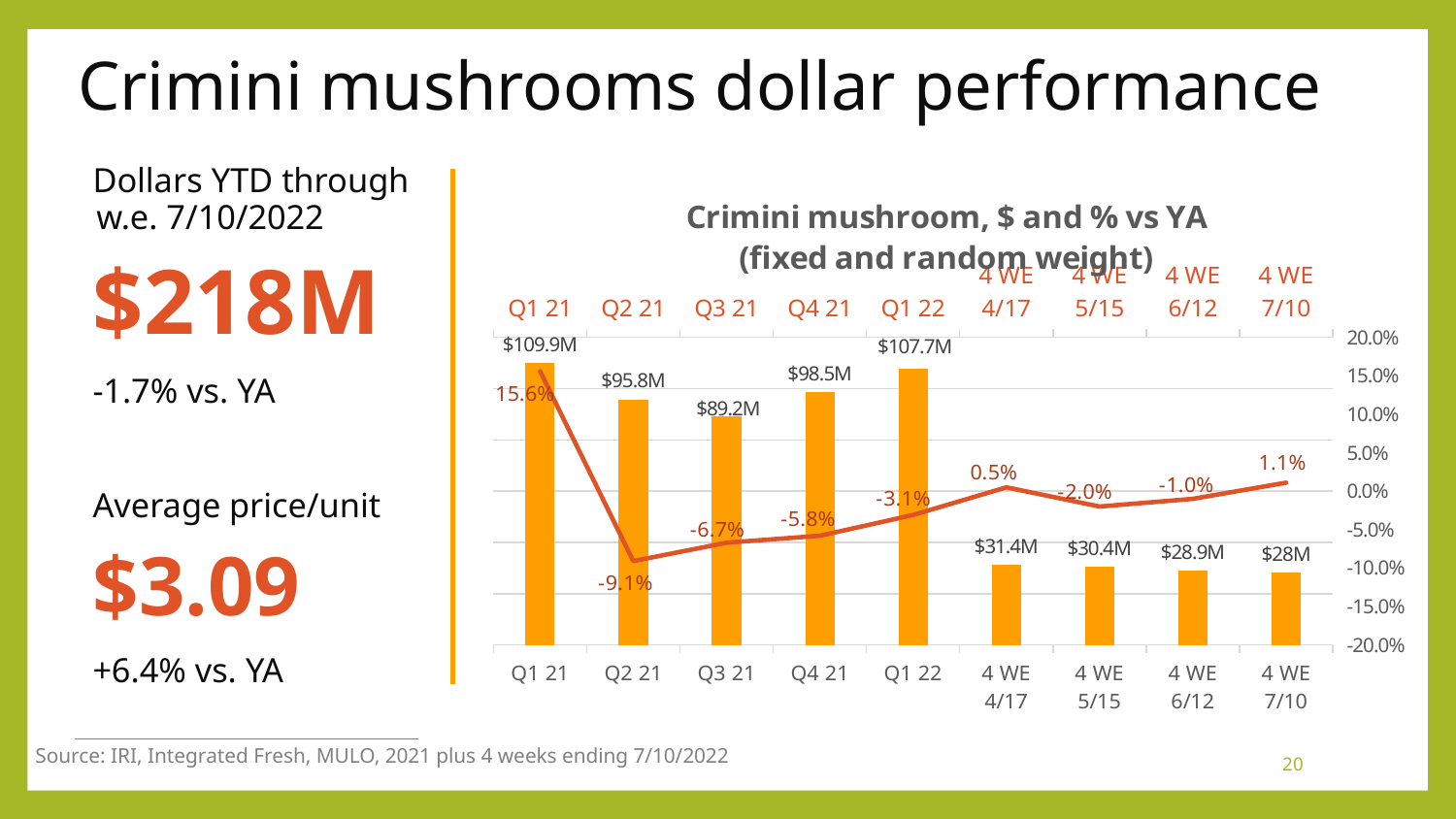
Which period has the highest dollar value? Q1 21 How many periods are shown on the x axis? 9 What is the dollar value for Q1 21? $109.9M What kind of chart is shown? Combined bar and line chart What is the dollar value for the 4 WE 7/10 period? $28M Do the % vs YA values rise or fall from the 4 WE 6/12 period to the 4 WE 7/10 period? Rise Which has the larger dollar value, Q3 21 or Q2 21? Q2 21 What is the % vs YA value for the 4 WE 4/17 period? 0.5% What is the % vs YA value for Q2 21? -9.1% Which period has the lowest % vs YA value? Q2 21 What is the difference in dollar value between Q1 22 and Q4 21? $9.2M What is the title of the chart? Crimini mushroom, $ and % vs YA (fixed and random weight)